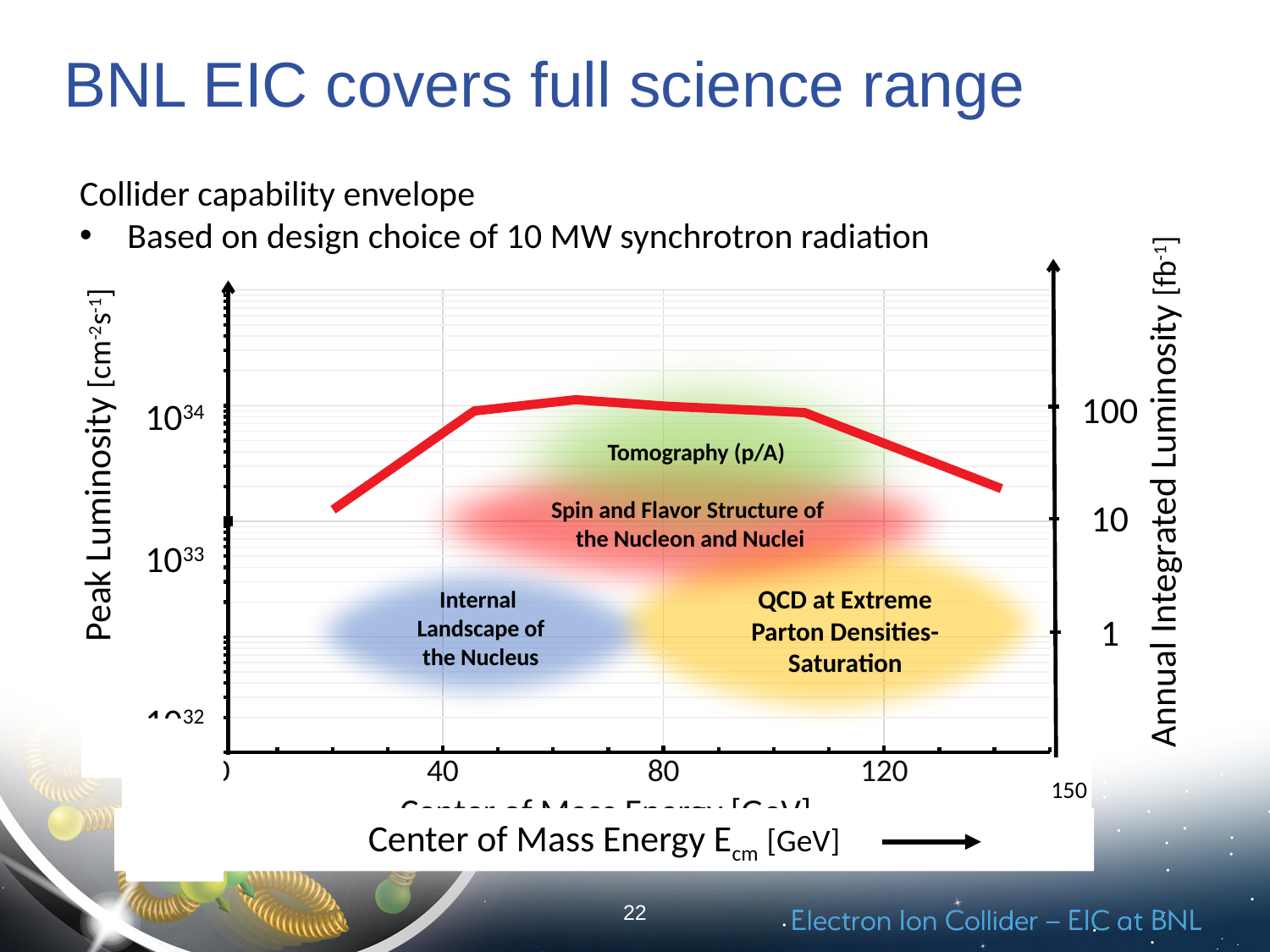
What is the label of the left vertical axis of the chart? Peak Luminosity [cm-2s-1] Is the peak luminosity at a center of mass energy of 120 GeV greater or less than 10^33? greater How many labeled science regions are shown on the chart? 4 What kind of chart is shown on the slide? line chart What colour is the collider capability envelope curve on the chart? red Does the peak luminosity curve rise or fall as the center of mass energy increases from 80 GeV to 120 GeV? fall Is the peak luminosity at a center of mass energy of 40 GeV greater or less than 10^33? greater Is the peak luminosity at a center of mass energy of 120 GeV greater or less than 10^34? less Which has the higher peak luminosity on the curve: 40 GeV or 80 GeV center of mass energy? 80 GeV Which has the higher peak luminosity on the curve: 80 GeV or 120 GeV center of mass energy? 80 GeV What is the label of the right vertical axis of the chart? Annual Integrated Luminosity [fb-1]